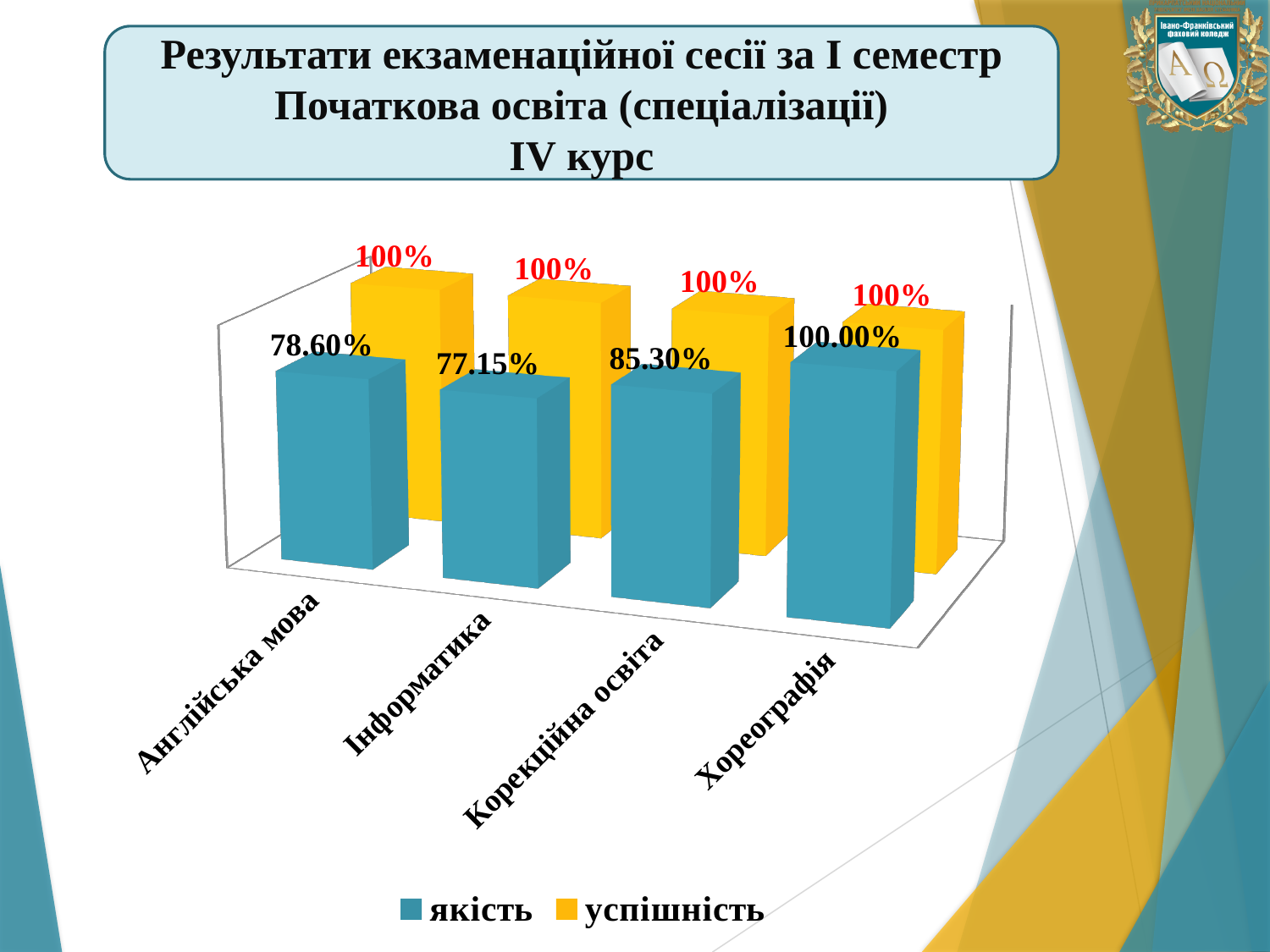
What is the якість value for Інформатика? 77.15% How many categories are shown on the chart? 4 What kind of chart is shown on the slide? Bar chart Which category has the lowest якість value? Інформатика What is the успішність value for Інформатика? 100% Which category has the highest якість value? Хореографія What is the якість value for Хореографія? 100.00% How many series does the legend list? 2 What is the difference between the якість values for Корекційна освіта and Англійська мова? 6.70% What is the якість value for Корекційна освіта? 85.30% What is the якість value for Англійська мова? 78.60% Which is larger, the якість value for Англійська мова or for Інформатика? Англійська мова